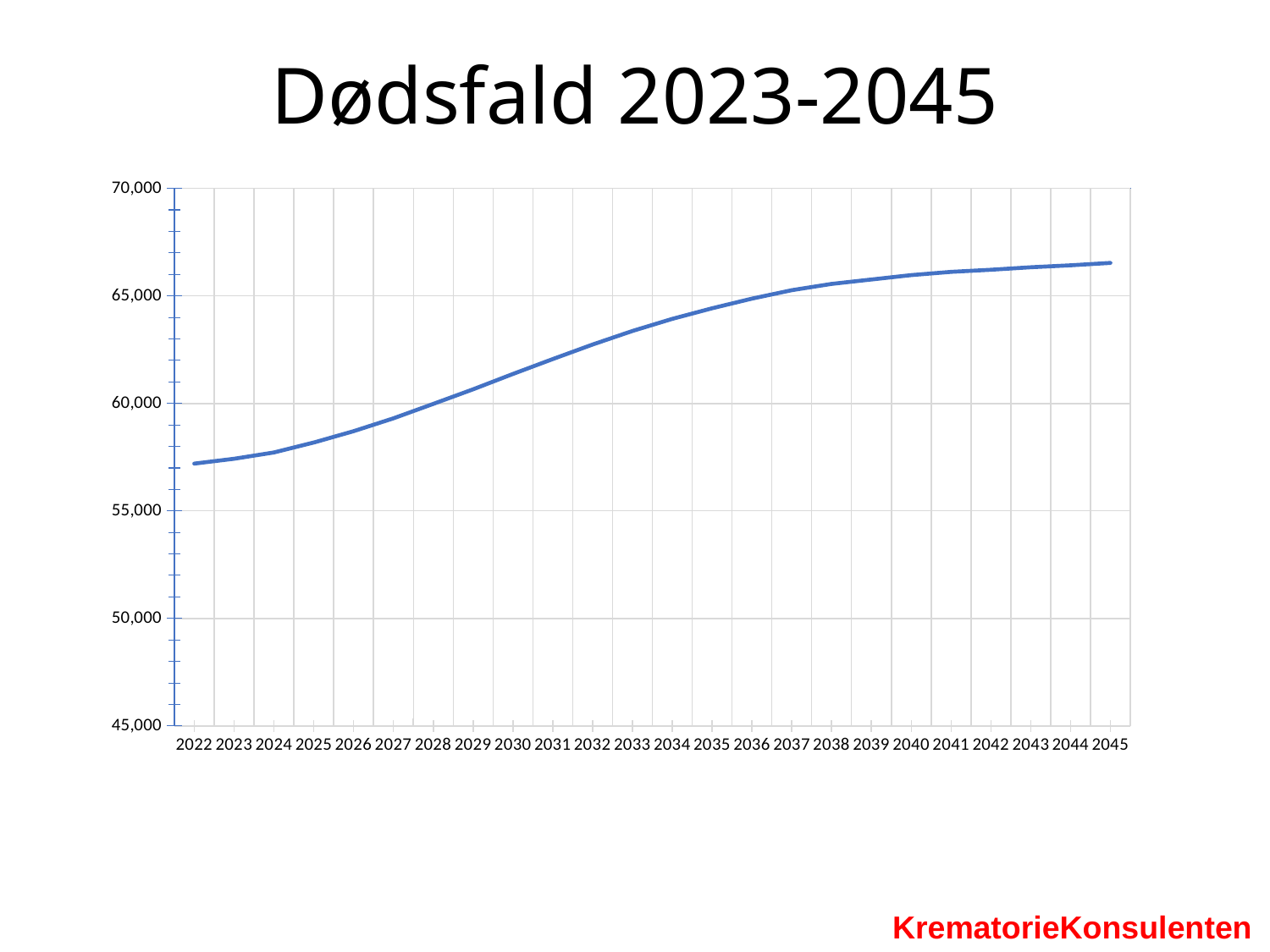
Is the value for 2030 greater or less than 60,000? greater Which year has the lowest value on the line? 2022 Is the value for 2025 greater or less than 60,000? less Is the value for 2022 greater or less than 60,000? less How many years are plotted along the x axis? 24 Which year has the larger value, 2024 or 2040? 2040 What kind of chart is shown on the slide? line chart Which year has the highest value on the line? 2045 What is the title of the chart? Dødsfald 2023-2045 Do the values rise or fall from 2022 to 2045? rise